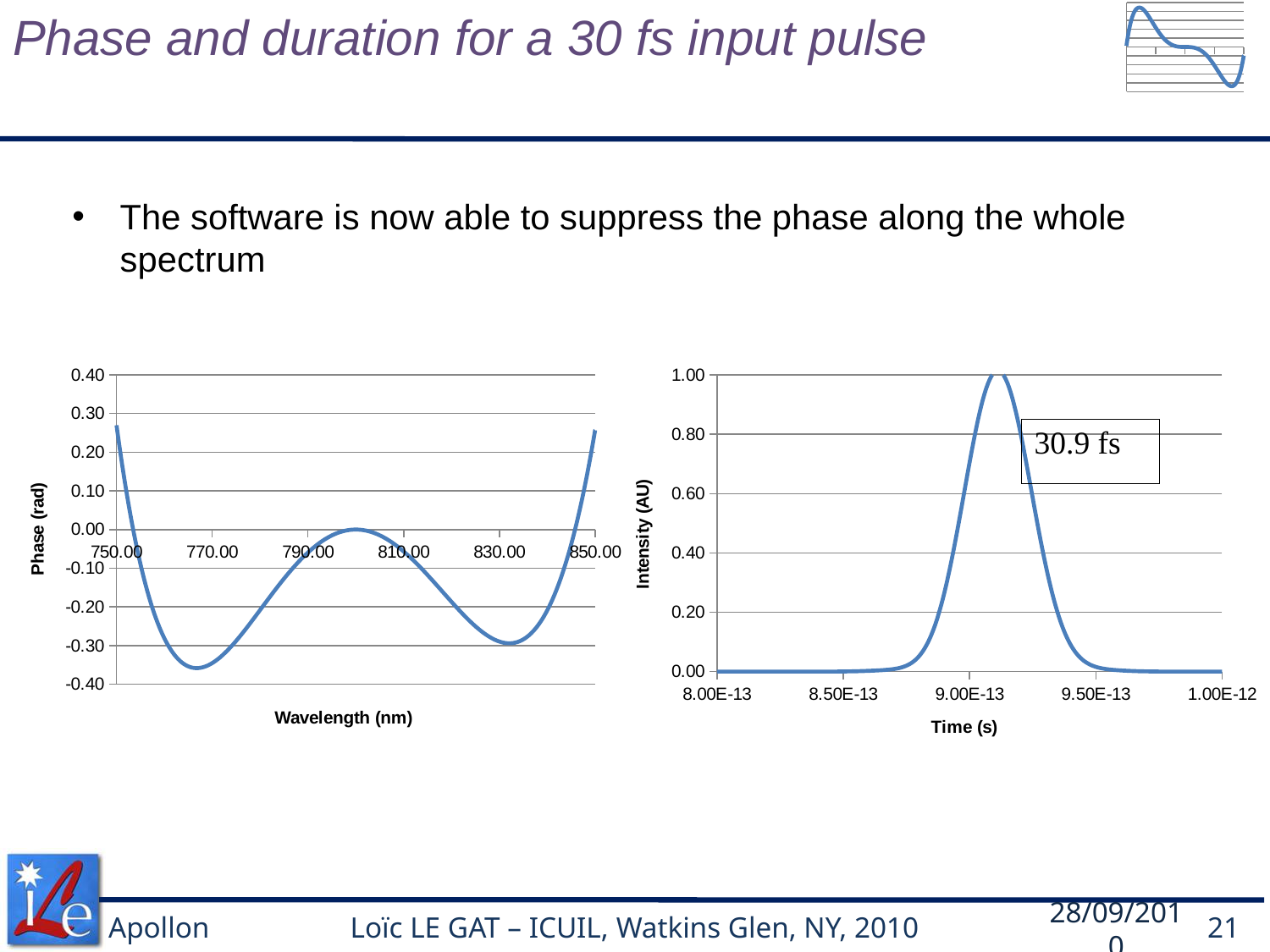
What kind of chart is the right chart (Intensity vs Time)? line chart In the right chart, what is the y-axis title? Intensity (AU) In the right chart, is the intensity at 9.00E-13 s greater or less than 0.40? greater What kind of chart is the left chart (Phase vs Wavelength)? line chart In the right chart, what pulse duration is written in the annotation box? 30.9 fs In the right chart, is the intensity at 8.50E-13 s greater or less than 0.20? less How many charts are shown on the slide? 2 In the left chart, is the phase at 850.00 nm greater or less than 0.10? greater In the left chart, what is the x-axis title? Wavelength (nm) In the right chart, what is the maximum intensity value reached by the curve? 1.00 In the left chart, is the phase at 750.00 nm greater or less than the phase at 770.00 nm? greater